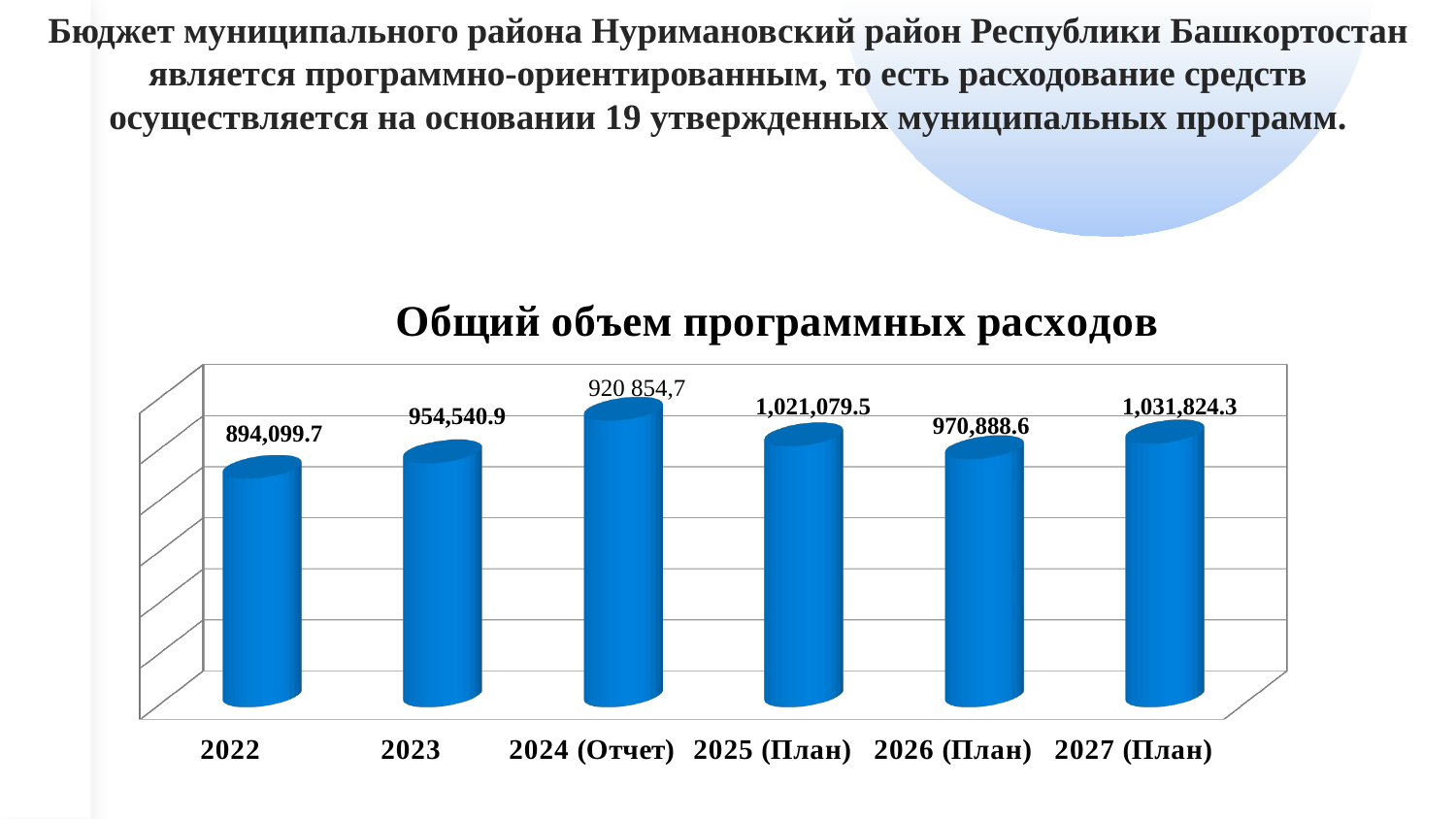
What is the difference between the values for 2025 (План) and 2026 (План)? 50,190.9 What kind of chart is shown on the slide? Bar chart Which category has the lowest value in the chart? 2022 What is the difference between the values for 2023 and 2022? 60,441.2 What is the value for 2022 in the chart "Общий объем программных расходов"? 894,099.7 What is the value for 2027 (План) in the chart? 1,031,824.3 How many categories are shown on the x axis of the chart? 6 What is the value for 2023 in the chart? 954,540.9 What is the value for 2025 (План) in the chart? 1,021,079.5 What is the value for 2024 (Отчет) in the chart? 920 854,7